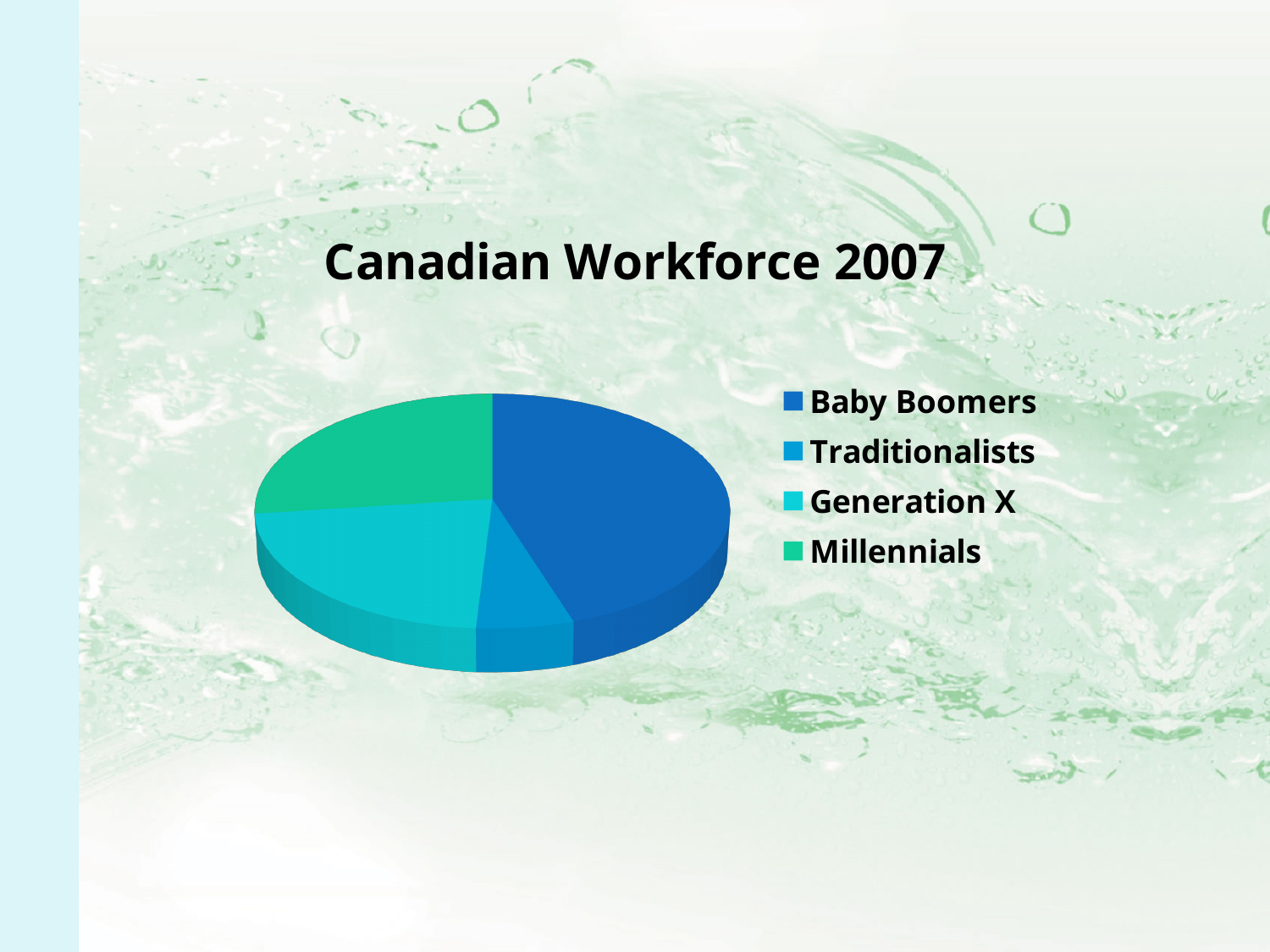
Which slice is larger, Generation X or Traditionalists? Generation X Which category has the smallest slice of the pie? Traditionalists Which slice is larger, Baby Boomers or Millennials? Baby Boomers Which category has the largest slice of the pie? Baby Boomers Which slice is larger, Baby Boomers or Traditionalists? Baby Boomers What kind of chart is shown on the slide? pie chart What is the title of the chart? Canadian Workforce 2007 How many categories does the pie chart show? 4 How many entries does the legend list? 4 Which category is listed first in the legend? Baby Boomers